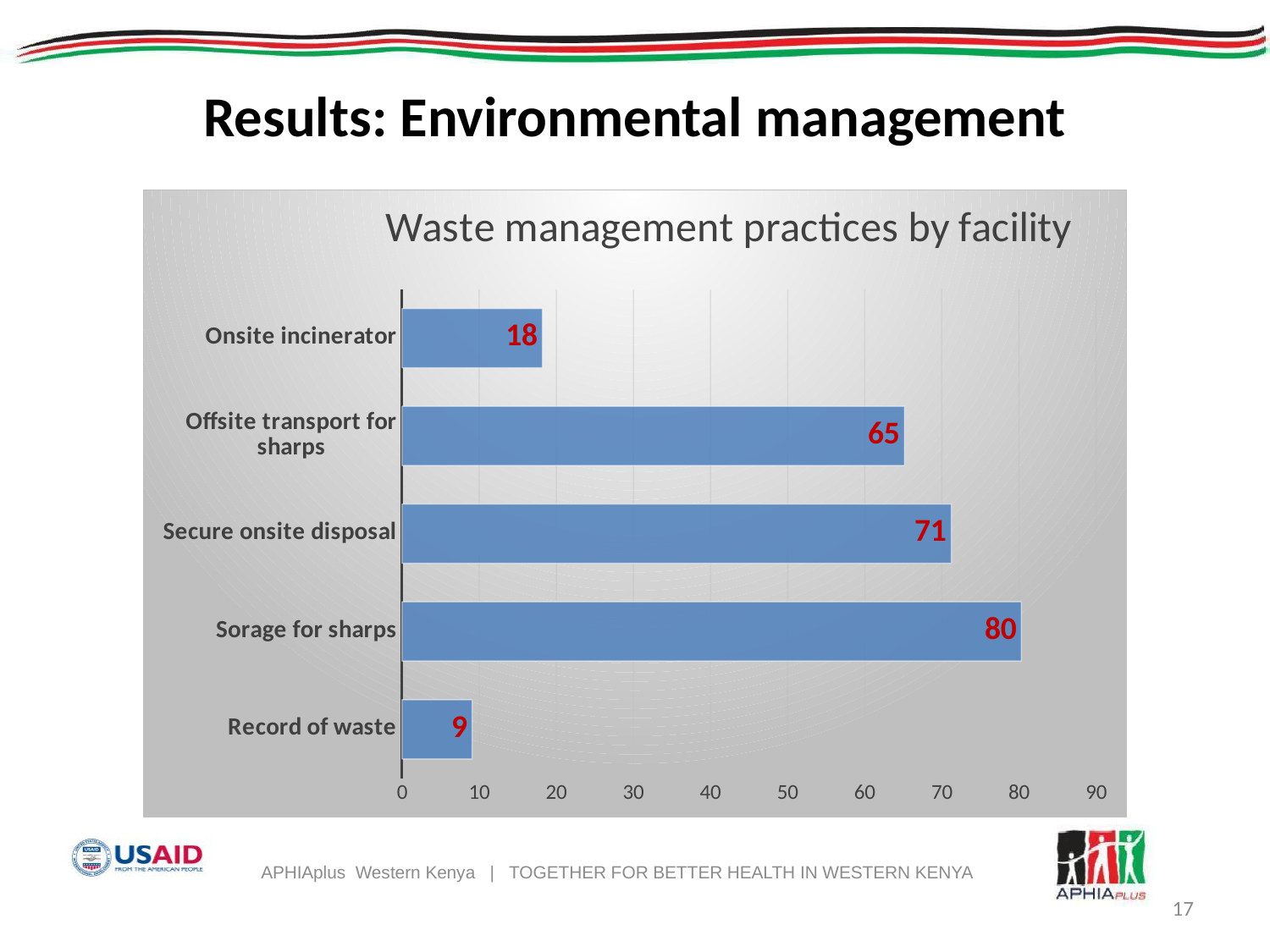
What is the difference between the values for Secure onsite disposal and Offsite transport for sharps? 6 What kind of chart is shown on the slide? Bar chart How many categories are shown in the chart? 5 What is the title of the chart? Waste management practices by facility What is the difference between the values for Sorage for sharps and Record of waste? 71 What is the value for Secure onsite disposal? 71 What is the value for Offsite transport for sharps? 65 What is the value for Record of waste? 9 Which is larger, the value for Onsite incinerator or the value for Offsite transport for sharps? Offsite transport for sharps Which category has the highest value? Sorage for sharps Which category has the lowest value? Record of waste What is the value for Onsite incinerator? 18